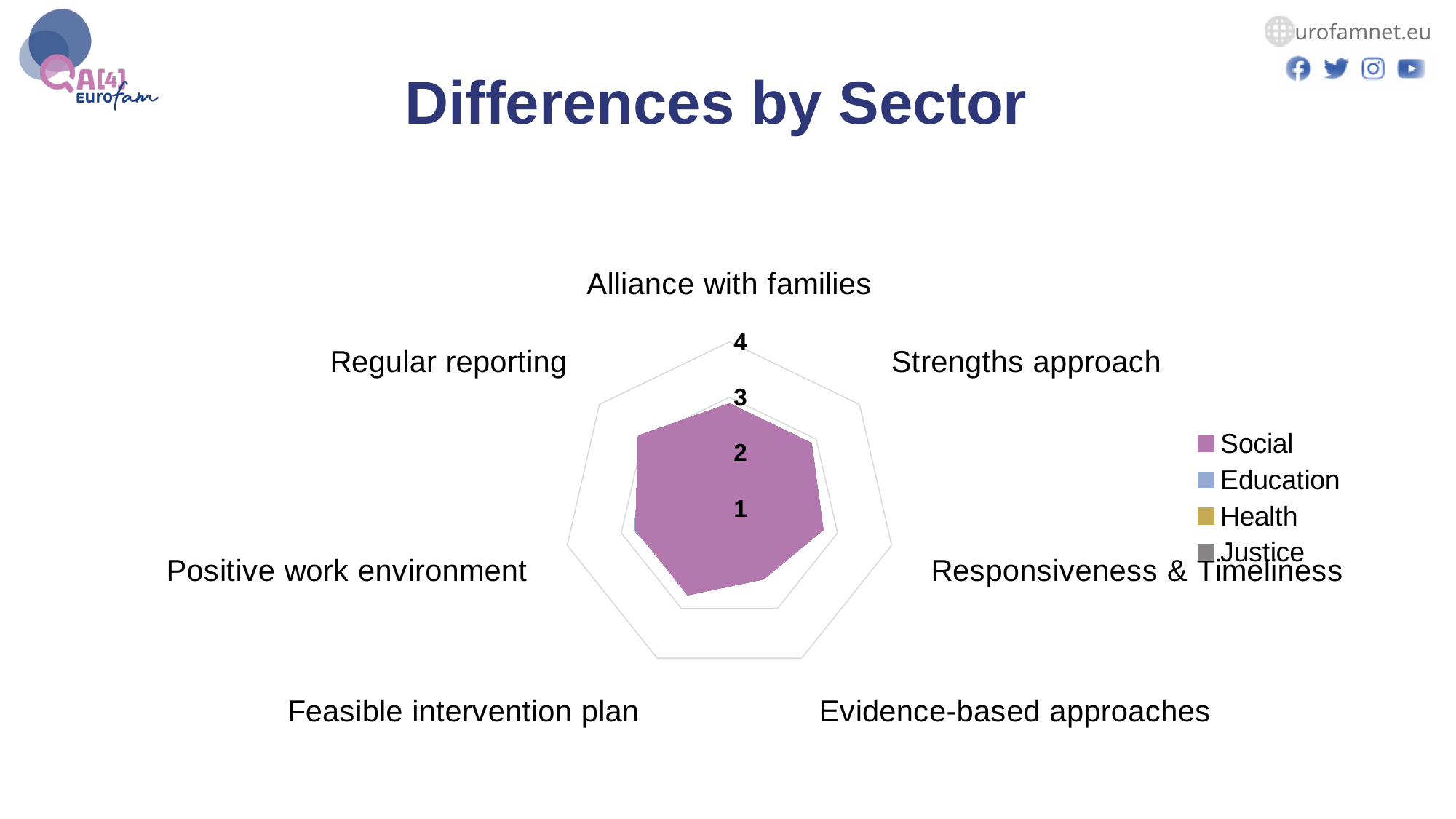
Is the Social value for Responsiveness & Timeliness greater or less than 4? less Is the Social value for Alliance with families greater or less than 4? less What is the highest value marked on the radar chart's scale? 4 Is the Social value for Feasible intervention plan greater or less than 4? less What kind of chart is shown on the slide? Radar chart What is the title of the slide's chart? Differences by Sector How many series does the legend list? 4 Which series is shown in purple in the legend? Social How many categories (axes) does the radar chart have? 7